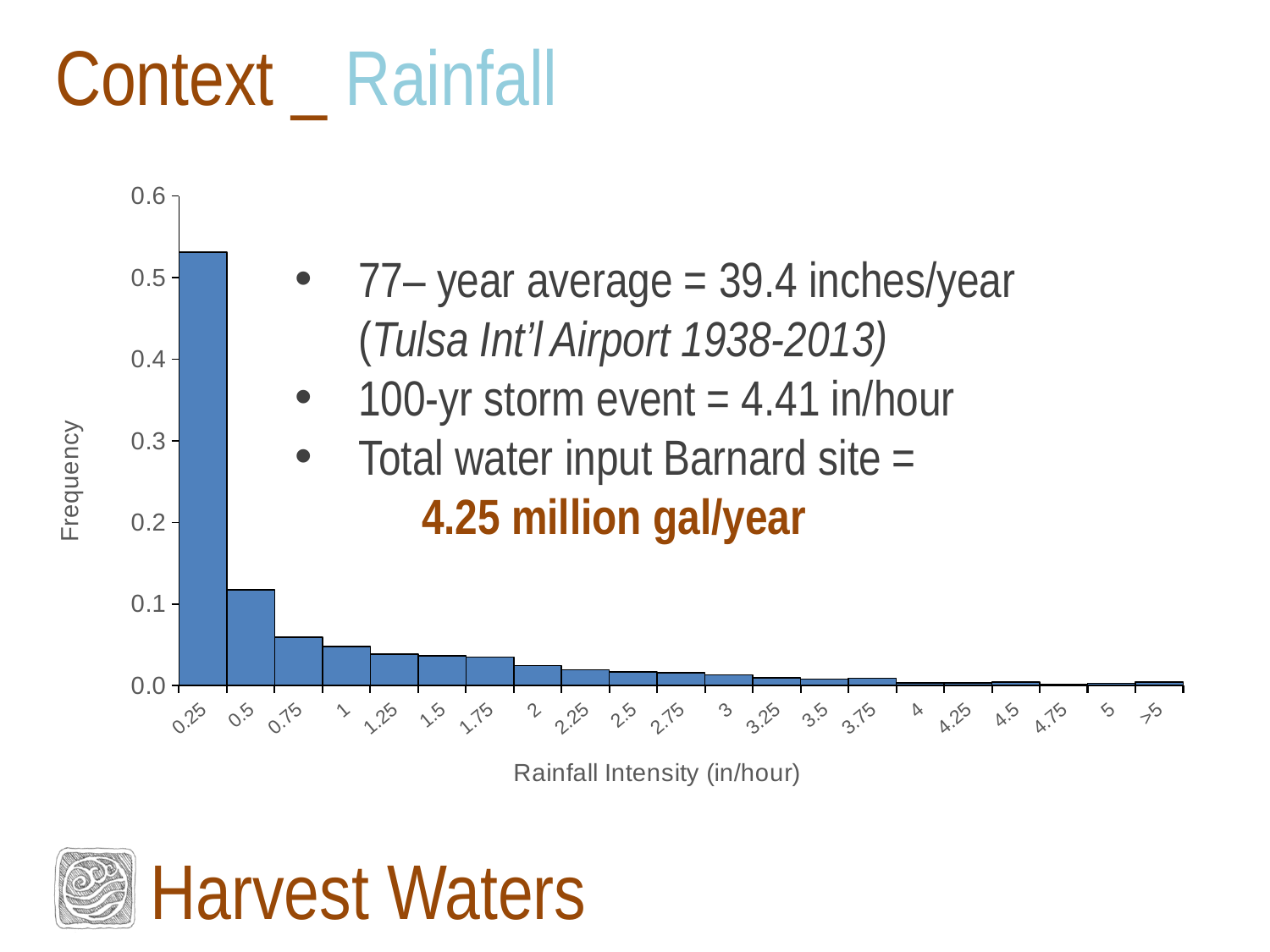
Is the frequency for the 0.75 in/hour category greater or less than 0.1? less Which rainfall intensity category has the highest frequency? 0.25 Is the frequency for the 0.5 in/hour category greater or less than 0.1? greater Is the frequency for the 0.25 in/hour category greater or less than 0.6? less How many rainfall intensity categories are shown on the x axis? 21 Which has a higher frequency, the 0.25 category or the 0.5 category? 0.25 Which has a higher frequency, the 0.5 category or the 0.75 category? 0.5 What is the label of the x axis? Rainfall Intensity (in/hour) What is the label of the y axis? Frequency Do the frequencies generally rise or fall as rainfall intensity increases along the x axis? fall What kind of chart is shown on the slide? bar chart